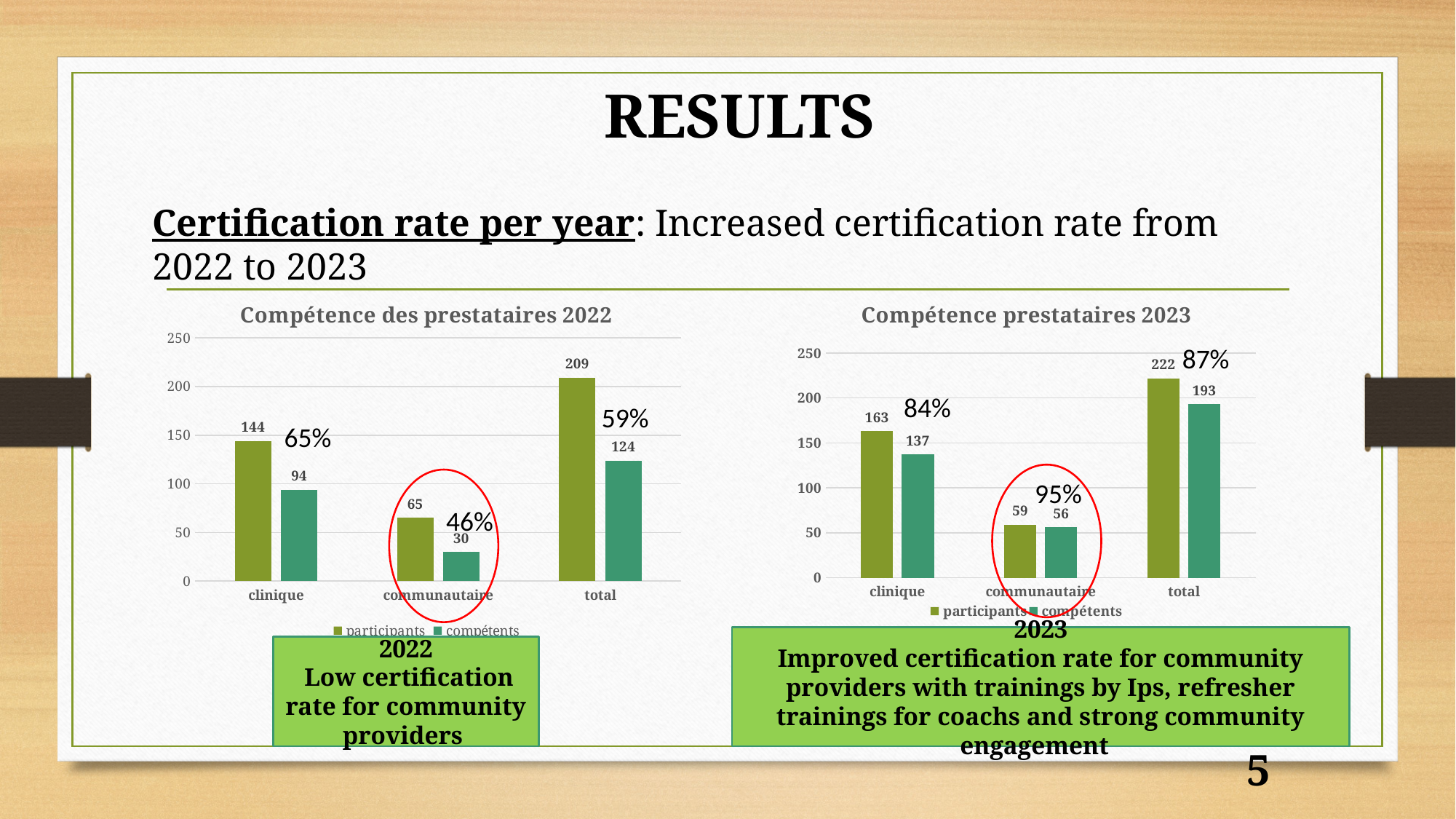
In the 'Compétence prestataires 2023' chart, which category has the lowest compétents value? communautaire How many categories are shown on the x axis of the 'Compétence des prestataires 2022' chart? 3 In the 'Compétence prestataires 2023' chart, what is the difference between participants and compétents in the clinique category? 26 In the 'Compétence des prestataires 2022' chart, which category has the highest participants value? total How many series does the legend of the 'Compétence prestataires 2023' chart list? 2 In the 'Compétence prestataires 2023' chart, what is the value for participants in the communautaire category? 59 What type of chart is 'Compétence des prestataires 2022'? Bar chart In the 'Compétence des prestataires 2022' chart, what is the value for participants in the clinique category? 144 Which is larger: the compétents value for communautaire in the 2022 chart or in the 2023 chart? 2023 chart In the 'Compétence des prestataires 2022' chart, what is the difference between participants and compétents in the total category? 85 In the 'Compétence prestataires 2023' chart, what is the value for compétents in the total category? 193 In the 'Compétence des prestataires 2022' chart, what is the value for compétents in the communautaire category? 30